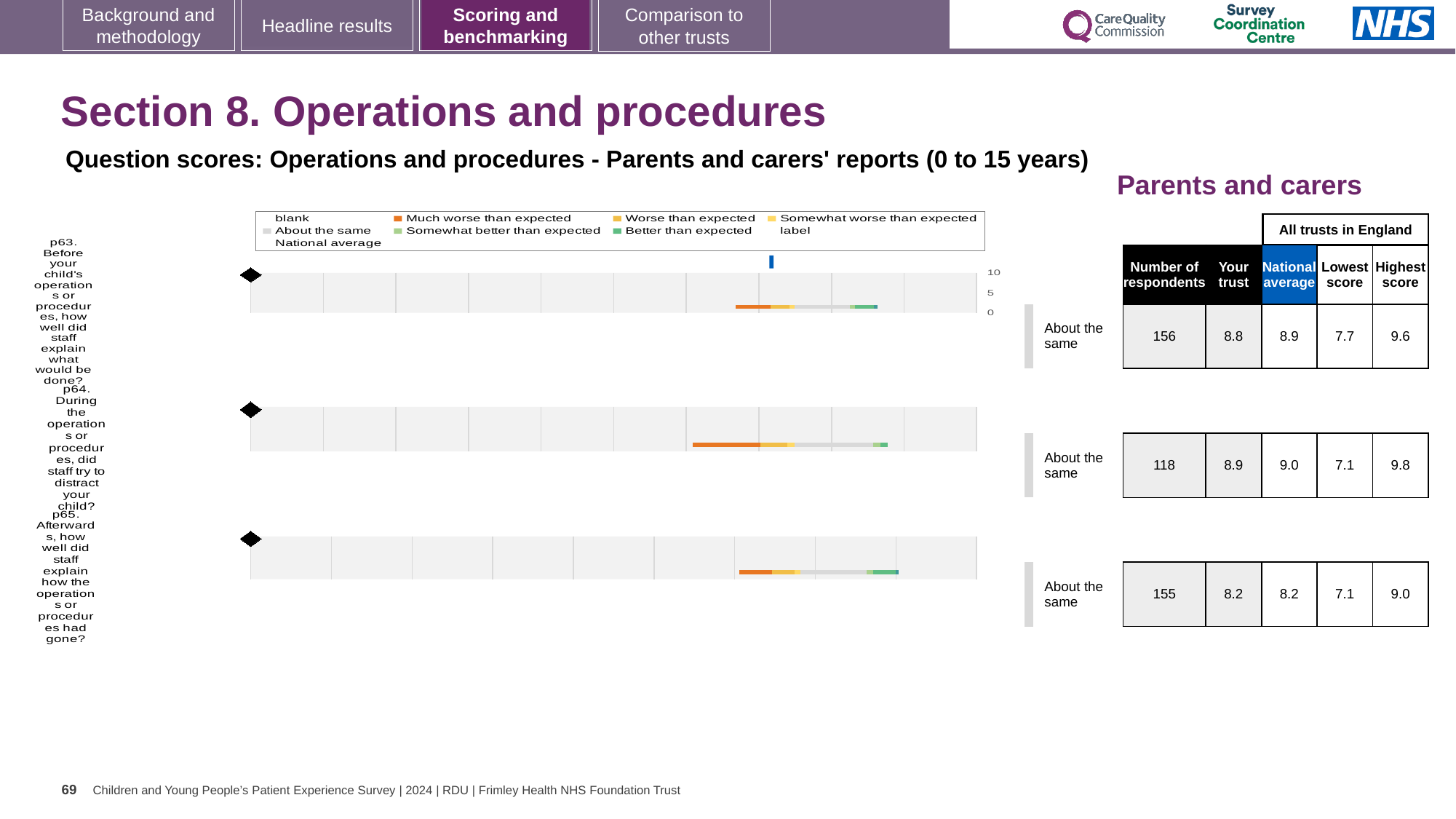
What is the 'Your trust' score for p63 (Before your child's operations or procedures, how well did staff explain what would be done?)? 8.8 How many respondents answered p65 (Afterwards, how well did staff explain how the operations or procedures had gone?)? 155 What is the difference between the highest score and the lowest score across all trusts in England for p63? 1.9 Which question has the highest 'Your trust' score? p64 How many questions are plotted in the benchmark charts on this slide? 3 Which question has the lowest 'Your trust' score? p65 What benchmark rating is shown for p64? About the same What is the highest score across all trusts in England for p65? 9.0 For p63, is the 'Your trust' score higher or lower than the national average? lower What kind of chart is used to show the question scores on this slide? bar chart How many more respondents answered p63 than p64? 38 What is the national average score for p64 (During the operations or procedures, did staff try to distract your child?)? 9.0